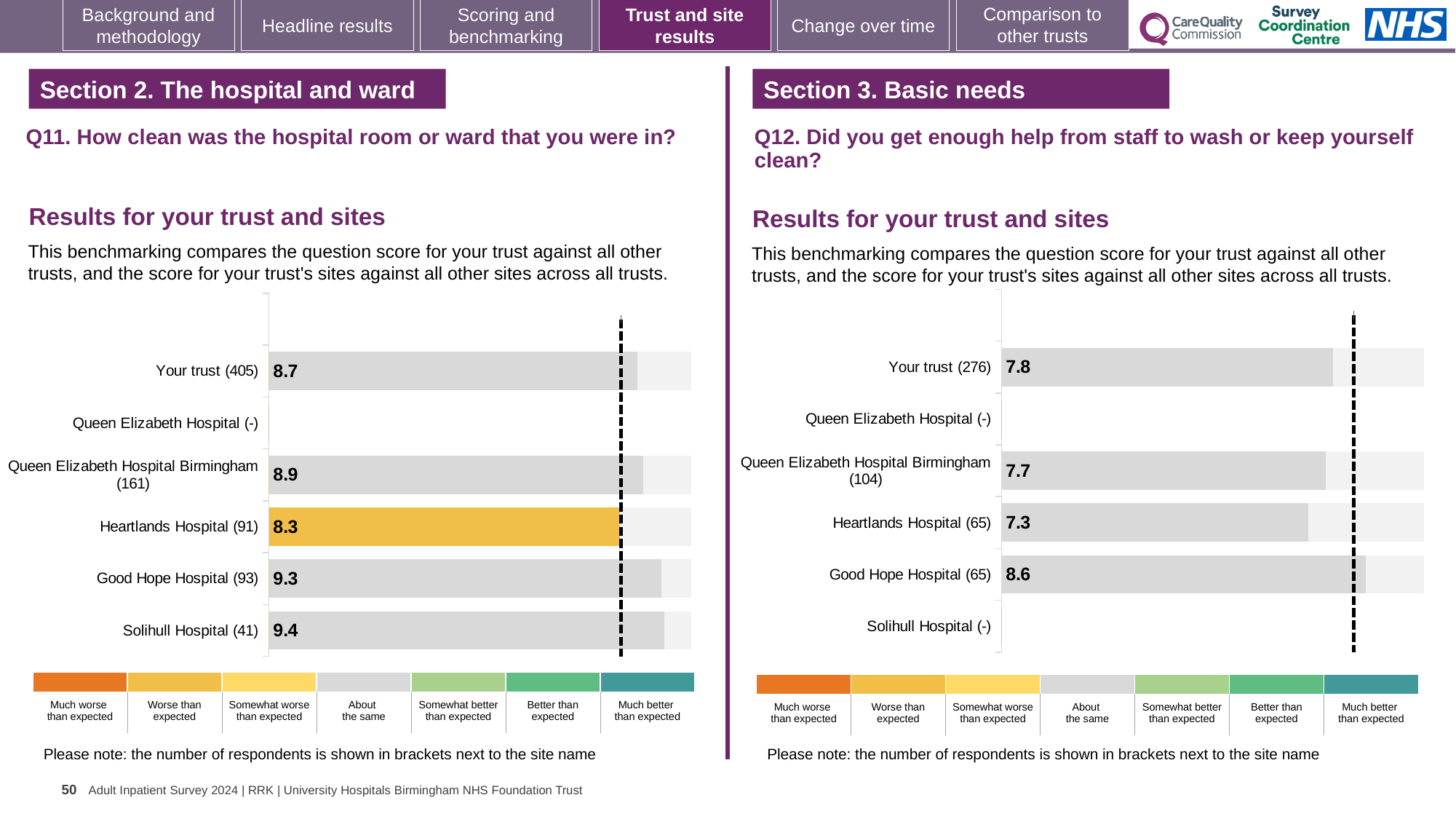
In the Q11 chart (left), what is the score for Your trust (405)? 8.7 In the Q12 chart (right), which site has the highest score? Good Hope Hospital (65) In the Q11 chart (left), which site has the highest score? Solihull Hospital (41) In the Q12 chart (right), what is the score for Heartlands Hospital (65)? 7.3 In the Q12 chart (right), what is the score for Good Hope Hospital (65)? 8.6 In the Q11 chart (left), which has the higher score: Queen Elizabeth Hospital Birmingham (161) or Your trust (405)? Queen Elizabeth Hospital Birmingham (161) In the Q11 chart (left), which site has the lowest score? Heartlands Hospital (91) How many rows (trust and sites) are listed in the Q12 chart (right)? 6 In the Q12 chart (right), what is the difference between the scores for Your trust (276) and Queen Elizabeth Hospital Birmingham (104)? 0.1 In the Q11 chart (left), what is the difference between the scores for Good Hope Hospital (93) and Heartlands Hospital (91)? 1.0 What type of chart is used for the Q11 results (left)? Bar chart